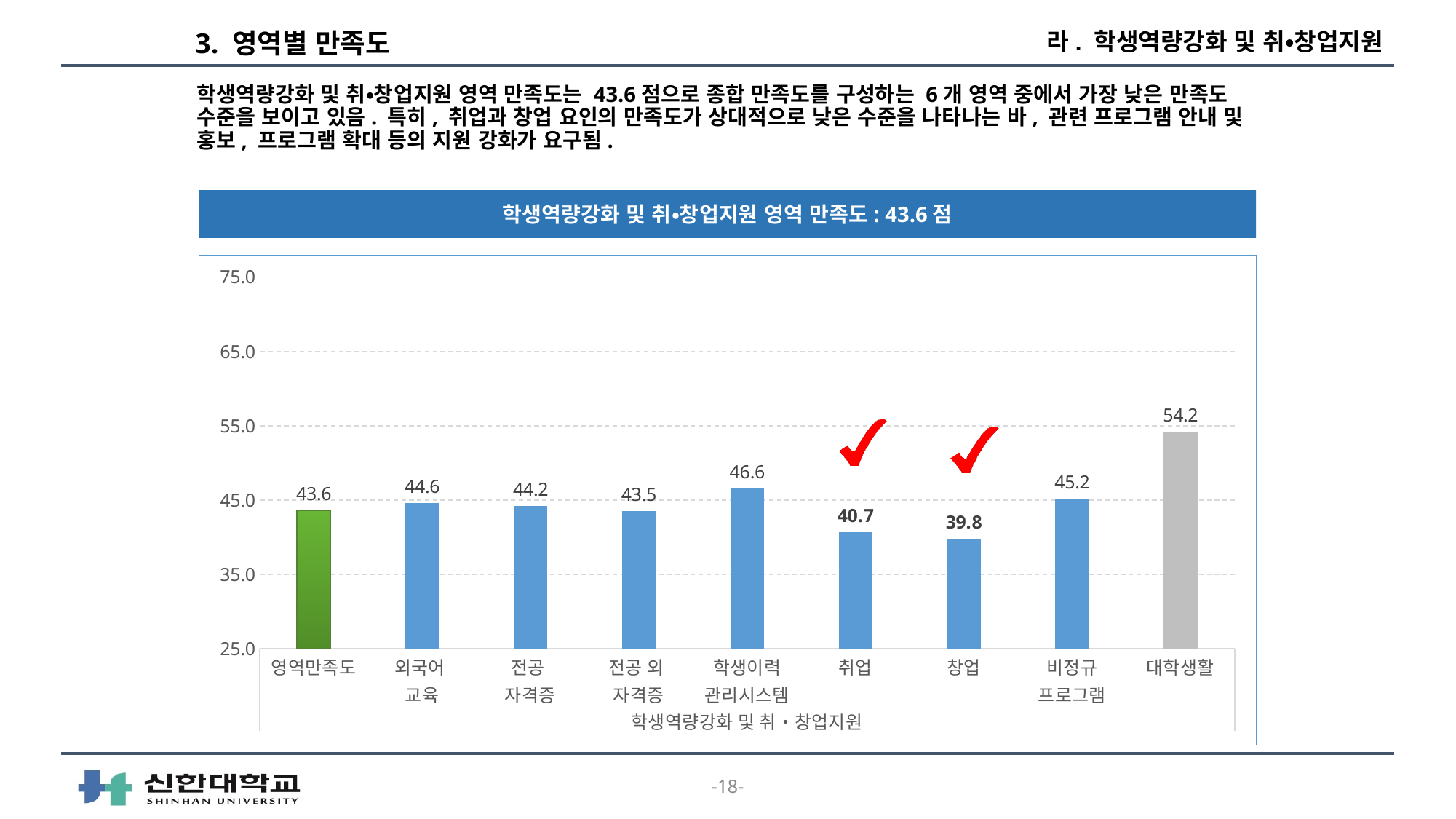
Which category has the highest value? 대학생활 Which category has the lowest value? 창업 How many bars are plotted in the chart? 9 What is the value for 대학생활? 54.2 What is the title shown above the chart? 학생역량강화 및 취•창업지원 영역 만족도 : 43.6 점 What is the difference between the values for 대학생활 and 창업? 14.4 What kind of chart is shown on the slide? bar chart What is the value for 취업? 40.7 Which is larger, the value for 비정규 프로그램 or the value for 취업? 비정규 프로그램 What is the value for 창업? 39.8 What is the difference between the values for 취업 and 창업? 0.9 What is the value for 학생이력 관리시스템? 46.6